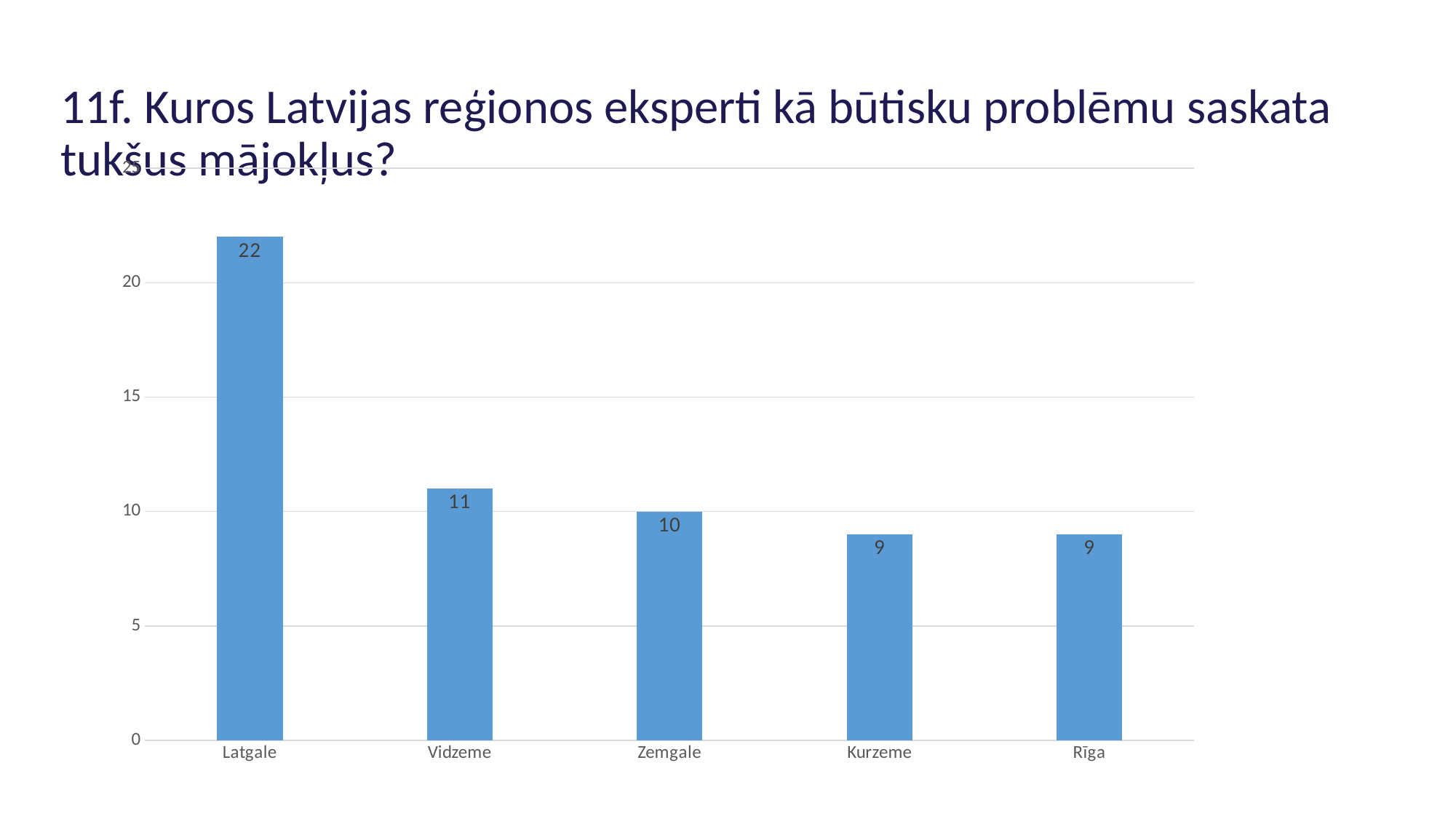
Do the values rise or fall from Latgale to Rīga along the x axis? fall Is the value for Latgale greater or less than 20? greater What is the value for Zemgale? 10 Which is larger, the value for Latgale or the value for Zemgale? Latgale How many regions are shown on the chart? 5 What is the value for Vidzeme? 11 What is the value for Latgale? 22 Which region has the highest value? Latgale What kind of chart is shown on the slide? bar chart What is the difference between the values for Latgale and Vidzeme? 11 What is the value for Rīga? 9 What is the difference between the values for Zemgale and Kurzeme? 1